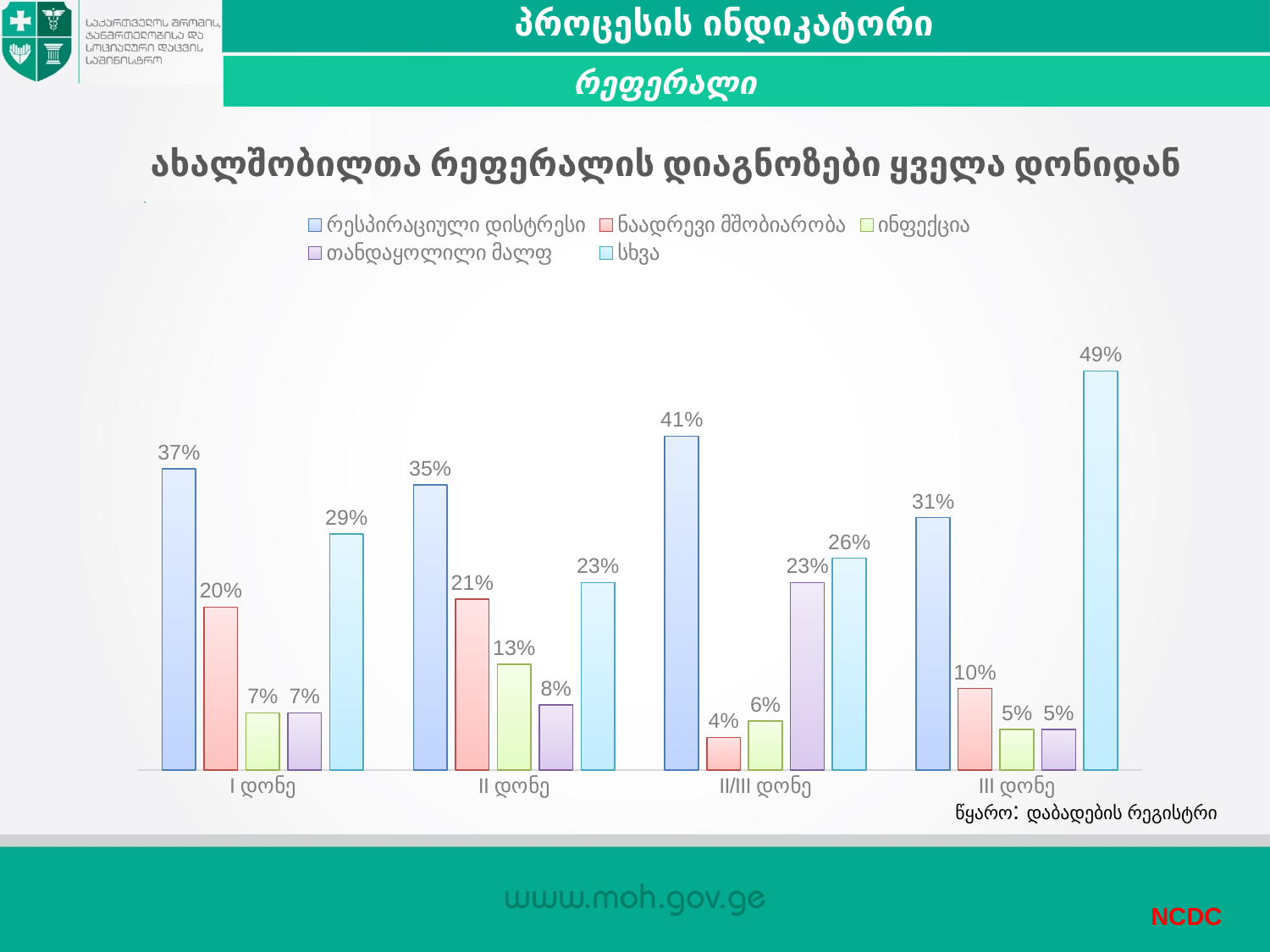
What is the source noted below the chart? დაბადების რეგისტრი Which category has the lowest value for ინფექცია? III დონე What kind of chart is shown on the slide? Bar chart What is the difference between სხვა and რესპირაციული დისტრესი in III დონე? 18% Which category has the highest value for რესპირაციული დისტრესი? II/III დონე How many categories are shown on the x axis? 4 How many series does the legend list? 5 What is the value for სხვა in III დონე? 49% Which is larger in II დონე: ნაადრევი მშობიარობა or სხვა? სხვა What is the value for თანდაყოლილი მალფ in II დონე? 8% What is the value for რესპირაციული დისტრესი in I დონე? 37% What is the value for ნაადრევი მშობიარობა in II/III დონე? 4%